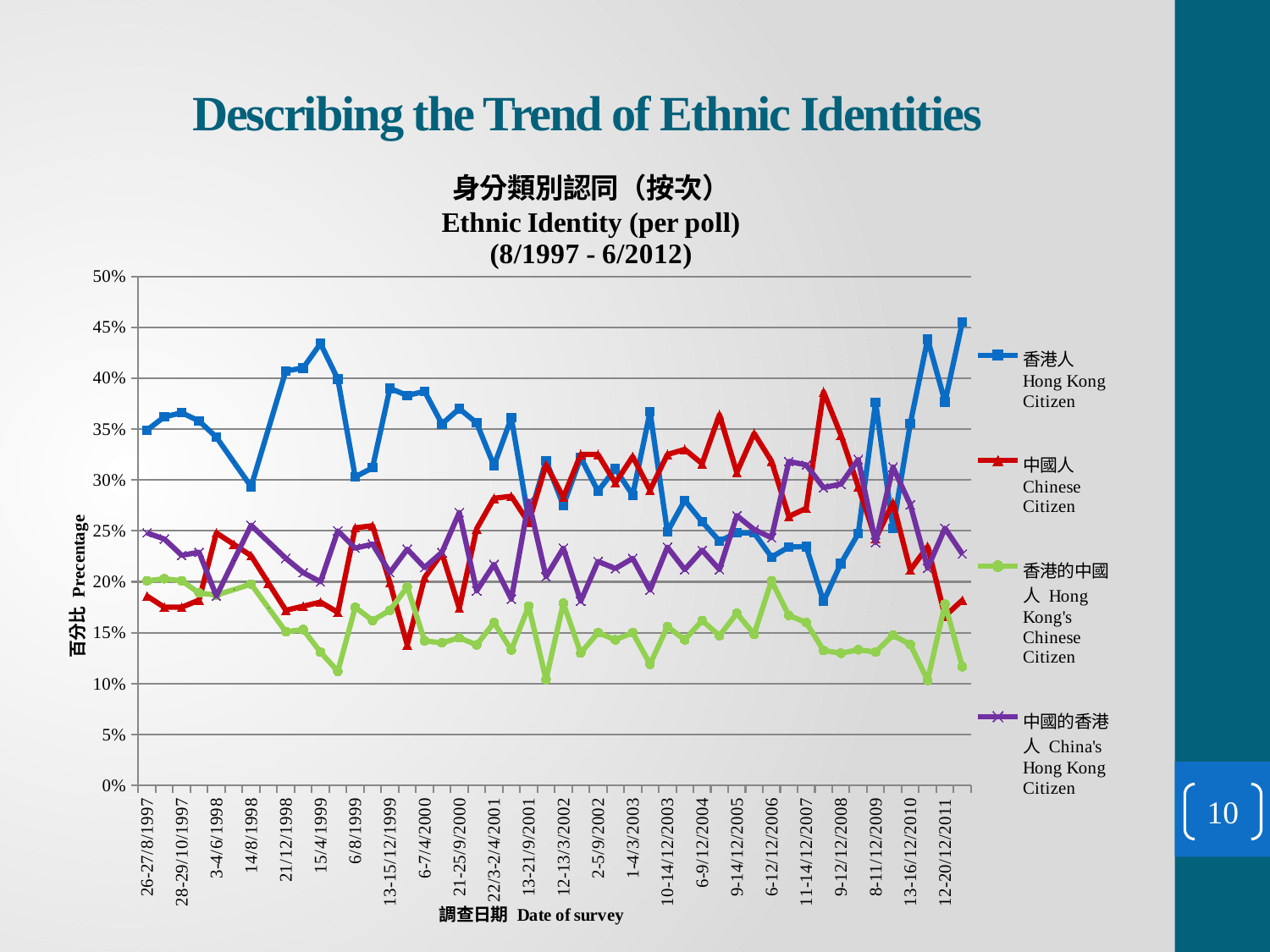
Is the value for Hong Kong's Chinese Citizen at 6/8/1999 greater or less than 15%? greater What is the English label on the x axis? Date of survey At 11-14/12/2007, which is larger: Chinese Citizen or Hong Kong Citizen? Chinese Citizen What is the English title of the chart? Ethnic Identity (per poll) (8/1997 - 6/2012) Is the value for Chinese Citizen at 11-14/12/2007 greater or less than 35%? less Is the value for Hong Kong Citizen at 15/4/1999 greater or less than 40%? greater Which series has the lowest value at 6/8/1999? Hong Kong's Chinese Citizen Which series has the highest value at 26-27/8/1997? Hong Kong Citizen What kind of chart is shown on the slide? line chart How many series does the legend list? 4 Does the Chinese Citizen line rise or fall between 11-14/12/2007 and 12-20/12/2011? fall